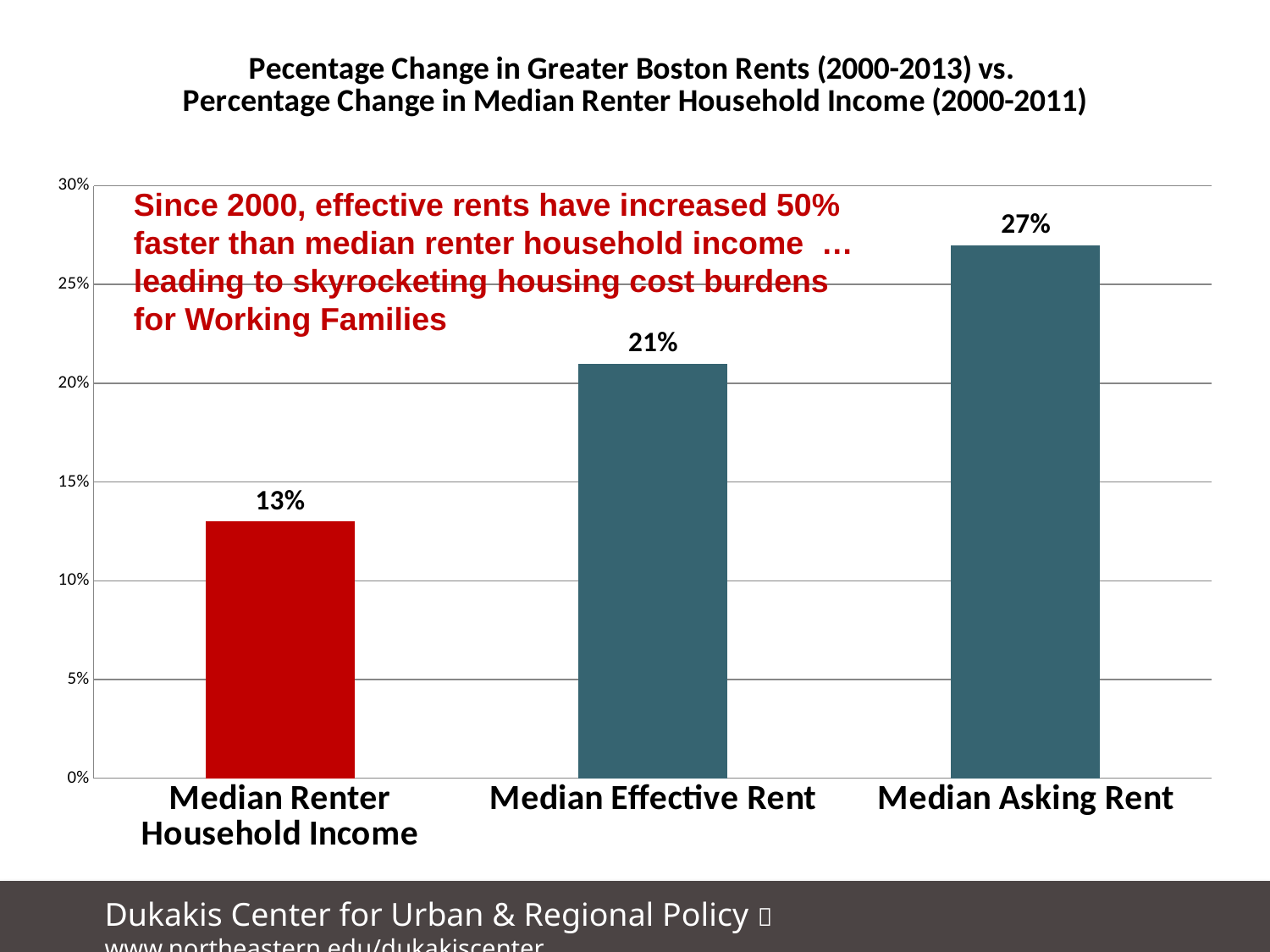
Which bar is coloured red? Median Renter Household Income What is the difference between Median Effective Rent and Median Renter Household Income? 8% What is the value for Median Effective Rent? 21% Is the value for Median Effective Rent greater or less than 20%? greater What is the value for Median Renter Household Income? 13% Which category has the lowest value? Median Renter Household Income What is the difference between Median Asking Rent and Median Renter Household Income? 14% What kind of chart is shown on the slide? bar chart Which is larger, Median Effective Rent or Median Asking Rent? Median Asking Rent What is the value for Median Asking Rent? 27% Which category has the highest value? Median Asking Rent How many categories are shown in the chart? 3